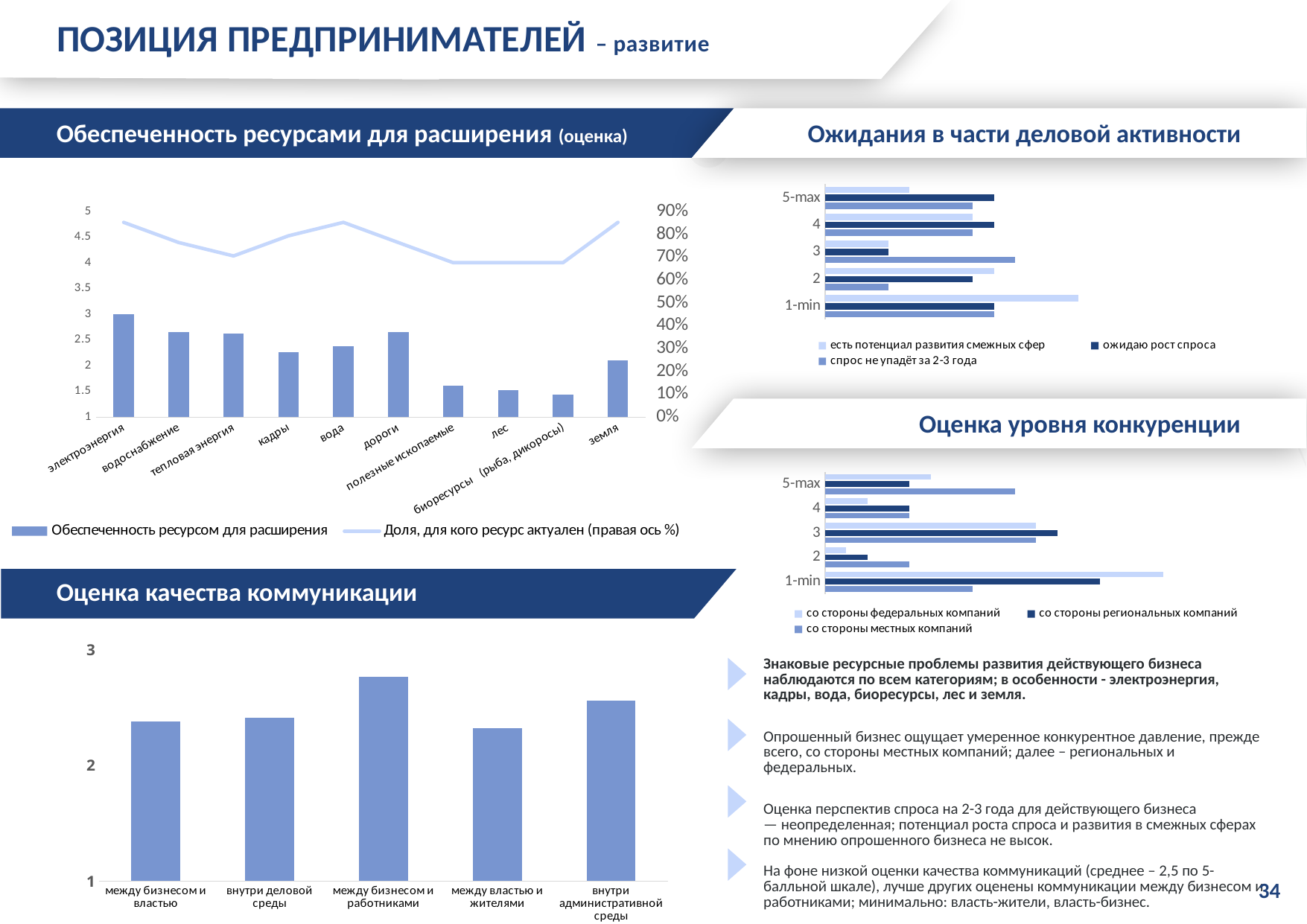
In the chart 'Обеспеченность ресурсами для расширения (оценка)', is the bar value for 'электроэнергия' greater or less than 2.5? greater What kind of chart is 'Оценка качества коммуникации'? bar chart In the chart 'Ожидания в части деловой активности', how many series does the legend list? 3 In the chart 'Обеспеченность ресурсами для расширения (оценка)', how many series does the legend list? 2 In the chart 'Обеспеченность ресурсами для расширения (оценка)', how many categories are shown on the x axis? 10 In the chart 'Оценка качества коммуникации', is the value for 'между бизнесом и работниками' greater or less than 3? less In the chart 'Обеспеченность ресурсами для расширения (оценка)', is the bar value for 'биоресурсы (рыба, дикоросы)' greater or less than 1.5? less In the chart 'Оценка уровня конкуренции', which series has the longest bar for the '1-min' category? со стороны федеральных компаний In the chart 'Обеспеченность ресурсами для расширения (оценка)', which bar is larger: 'электроэнергия' or 'лес'? электроэнергия In the chart 'Оценка качества коммуникации', which category has the highest bar? между бизнесом и работниками In the chart 'Обеспеченность ресурсами для расширения (оценка)', which category has the highest bar for 'Обеспеченность ресурсом для расширения'? электроэнергия